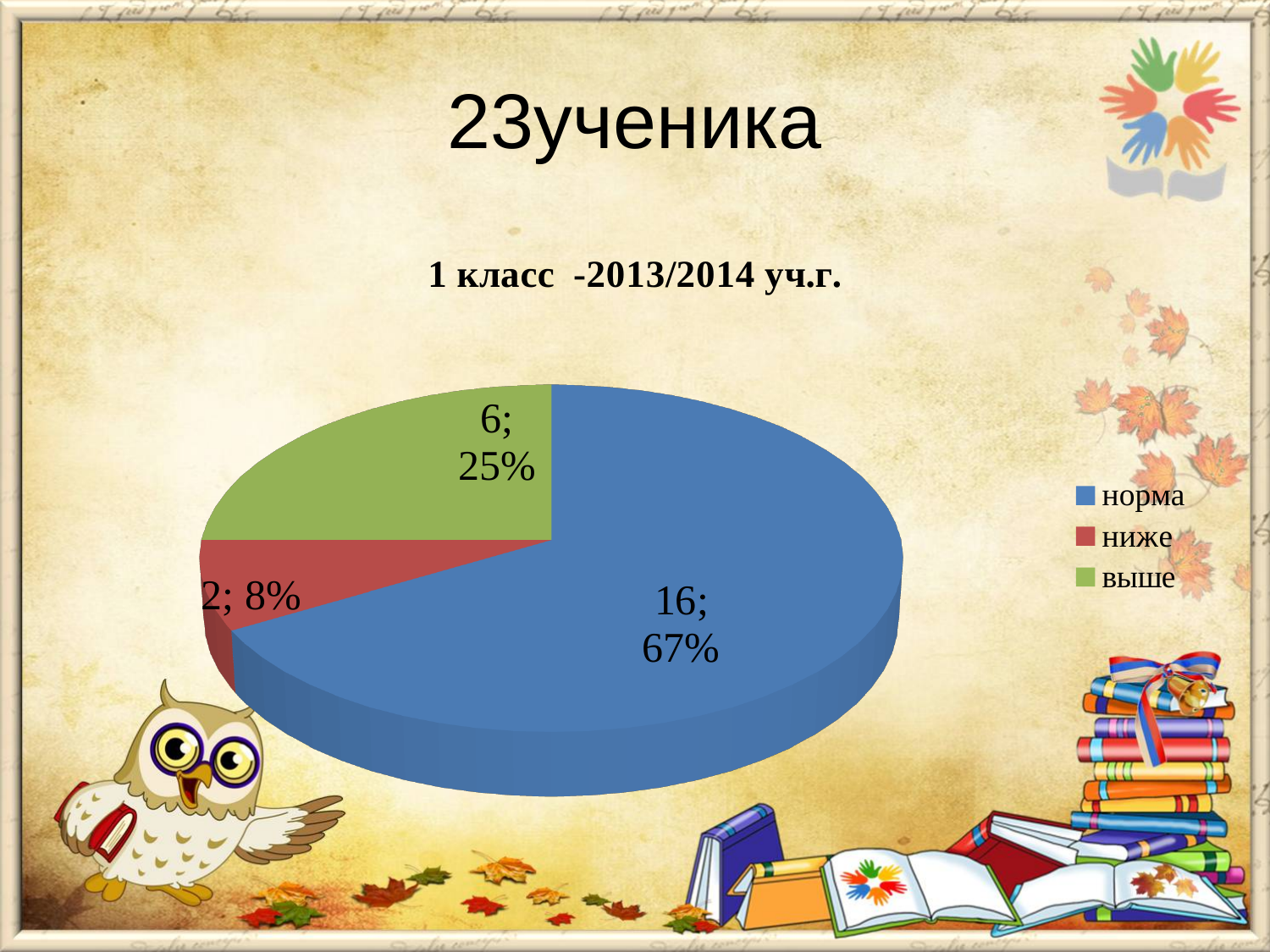
What is the value for выше? 6 What share of the pie does выше take? 25% What share of the pie does норма take? 67% Which category has the largest slice? норма How many slices does the pie chart have? 3 What is the value for норма? 16 What is the value for ниже? 2 What is the difference between the values for норма and выше? 10 What is the title of the chart? 1 класс -2013/2014 уч.г. Which category has the smallest slice? ниже How many entries does the legend list? 3 What kind of chart is shown on the slide? pie chart